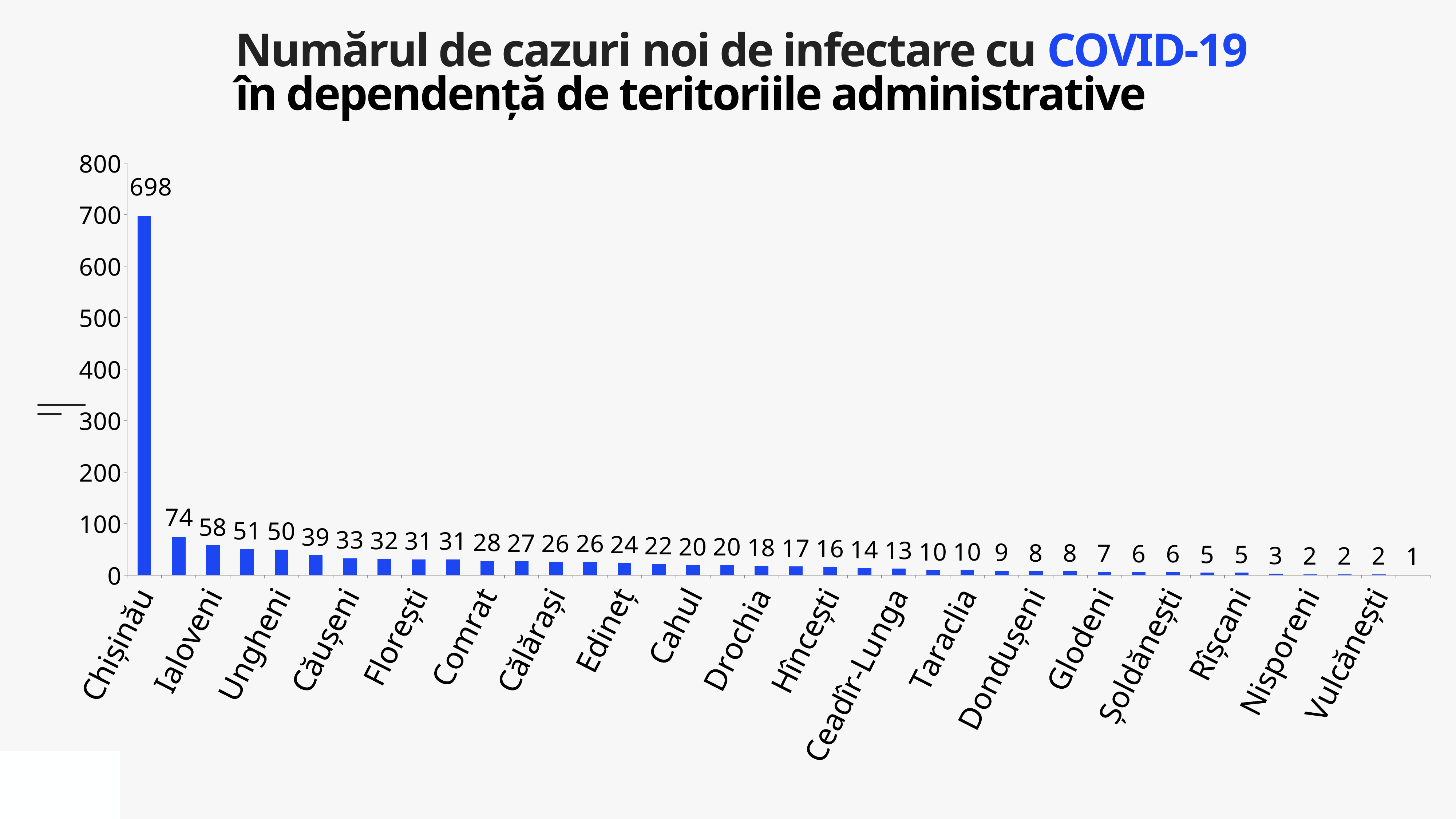
Which is larger, the value for Chișinău or the value for Ialoveni? Chișinău Which is larger, the value for Cahul or the value for Chișinău? Chișinău Is the value for Ialoveni greater or less than 100? less Is the value for Vulcănești greater or less than 100? less Is the value for Chișinău greater or less than 600? greater Which administrative territory has the highest number of new COVID-19 cases? Chișinău What is the highest value shown on the vertical axis? 800 What is the number of new COVID-19 cases for Chișinău? 698 Do the values rise or fall moving from left to right along the x axis? fall What kind of chart is shown on the slide? bar chart What is the smallest data label shown on the chart? 1